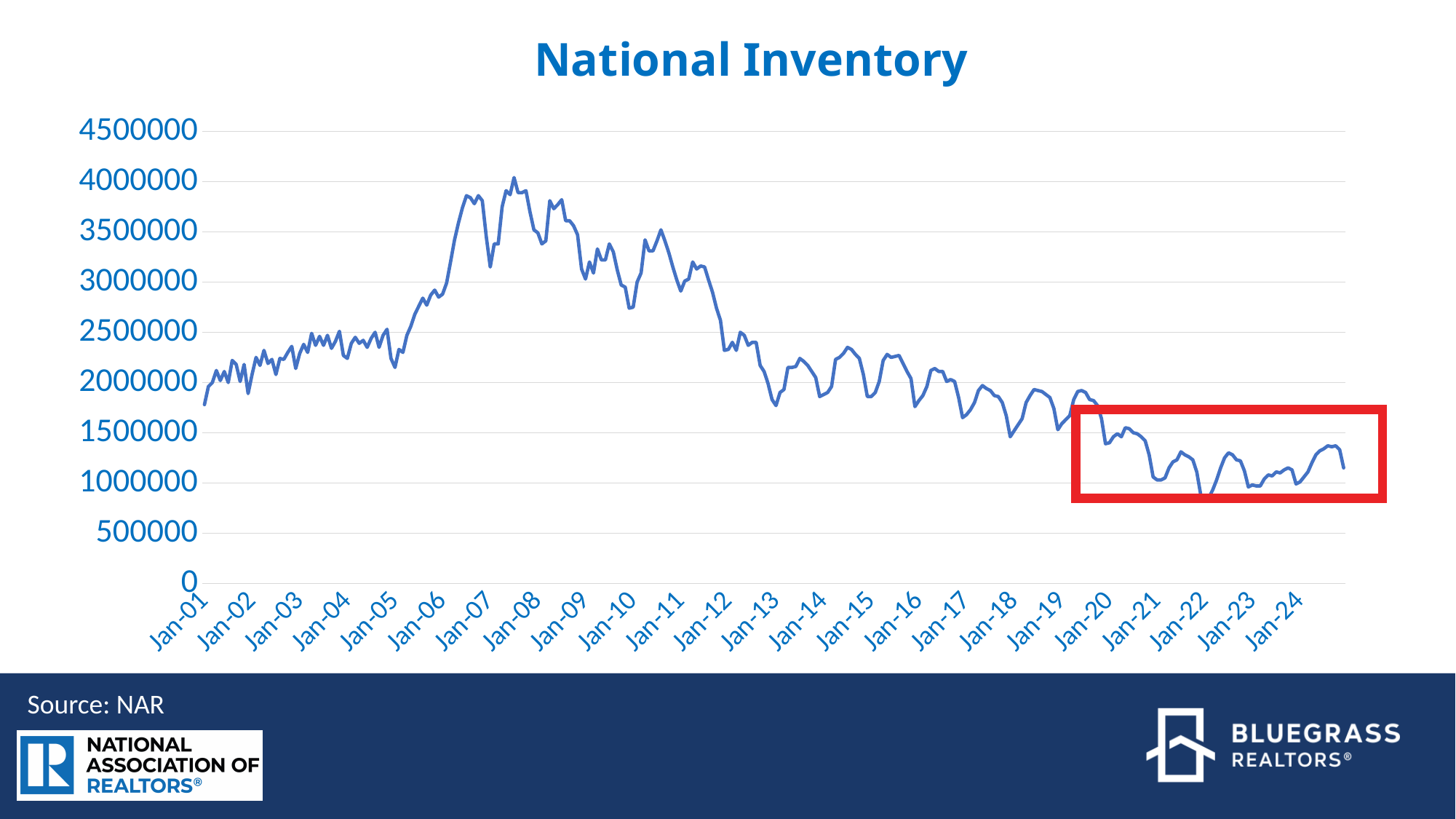
Is the value for Jan-01 greater or less than 2000000? less Does the line generally rise or fall between Jan-08 and Jan-22? fall Is the value for Jan-16 greater or less than 2000000? less How many year labels are shown on the x axis? 24 What kind of chart is shown on the slide? line chart What is the source cited for the chart data? NAR What is the title of the chart? National Inventory Is the value for Jan-10 greater or less than 3000000? less Does the line generally rise or fall between Jan-01 and Jan-07? rise